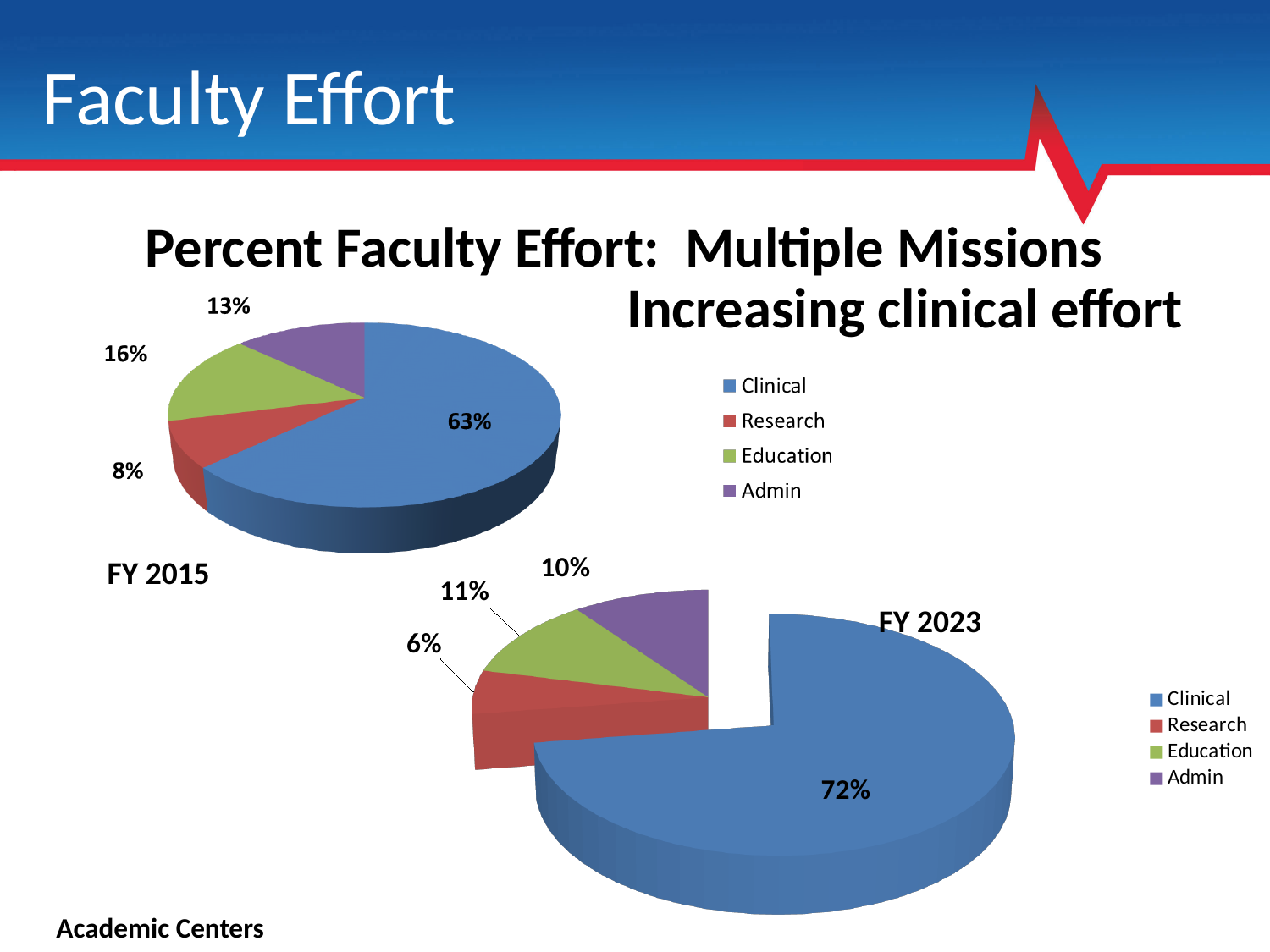
In the FY 2015 pie chart, which category has the smallest share? Research What colour represents Admin in the legend of the FY 2015 pie chart? Purple In the FY 2023 pie chart, which category has the largest share? Clinical In the FY 2023 pie chart, what is the value for Clinical? 72% In the FY 2023 pie chart, what is the difference between Education and Admin? 1% How many categories does the FY 2023 pie chart show? 4 In the FY 2015 pie chart, what is the value for Clinical? 63% In the FY 2015 pie chart, what is the value for Education? 16% In the FY 2023 pie chart, what is the value for Research? 6% In the FY 2015 pie chart, which is larger, Education or Admin? Education What is the difference between the Clinical share in FY 2023 and the Clinical share in FY 2015? 9% What kind of chart is used for FY 2015? Pie chart